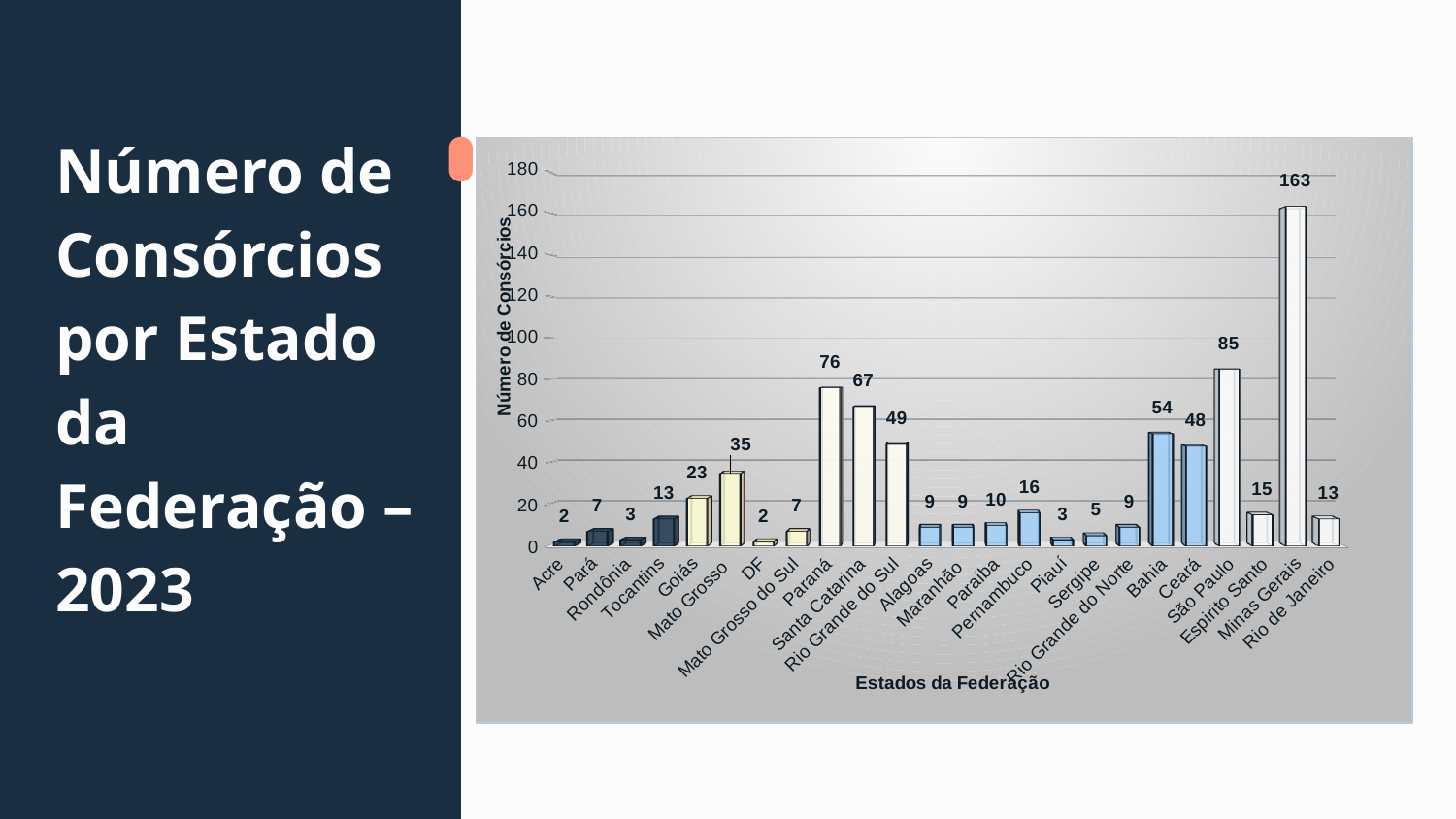
Which has a larger value, Goiás or Pernambuco? Goiás What is the number of consórcios for Paraná? 76 What is the label of the x axis of the chart? Estados da Federação What is the difference between the values for São Paulo and Rio de Janeiro? 72 How many states are shown on the x axis of the chart? 24 What is the number of consórcios for Minas Gerais? 163 What is the number of consórcios for Bahia? 54 What is the difference between the values for Santa Catarina and Rio Grande do Sul? 18 What type of chart is shown on the slide? bar chart What is the number of consórcios for Mato Grosso? 35 Which has a larger value, Bahia or Ceará? Bahia Which state has the highest number of consórcios? Minas Gerais